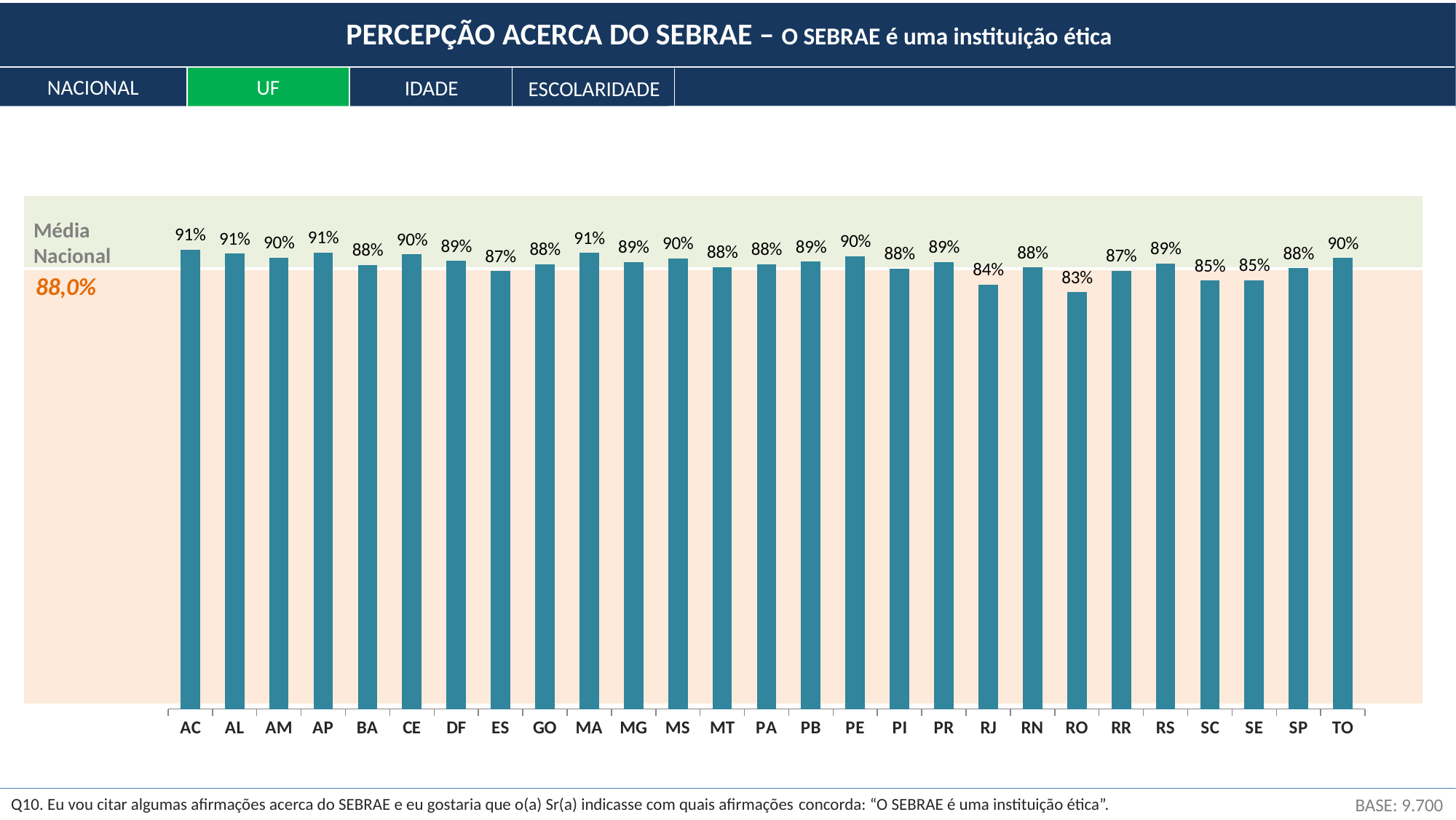
Which is larger, the value for PE or the value for RR? PE What is the difference between the values for AC and RO? 8% What is the difference between the values for TO and SC? 5% What is the value for MA? 91% What kind of chart is shown on the slide? Bar chart Which state has the lowest value? RO Which is larger, the value for SE or the value for AP? AP What is the value for SP? 88% What is the value for RJ? 84% How many states (UF) are shown on the x axis? 27 What is the Média Nacional value shown on the chart? 88,0% What is the value for RO? 83%